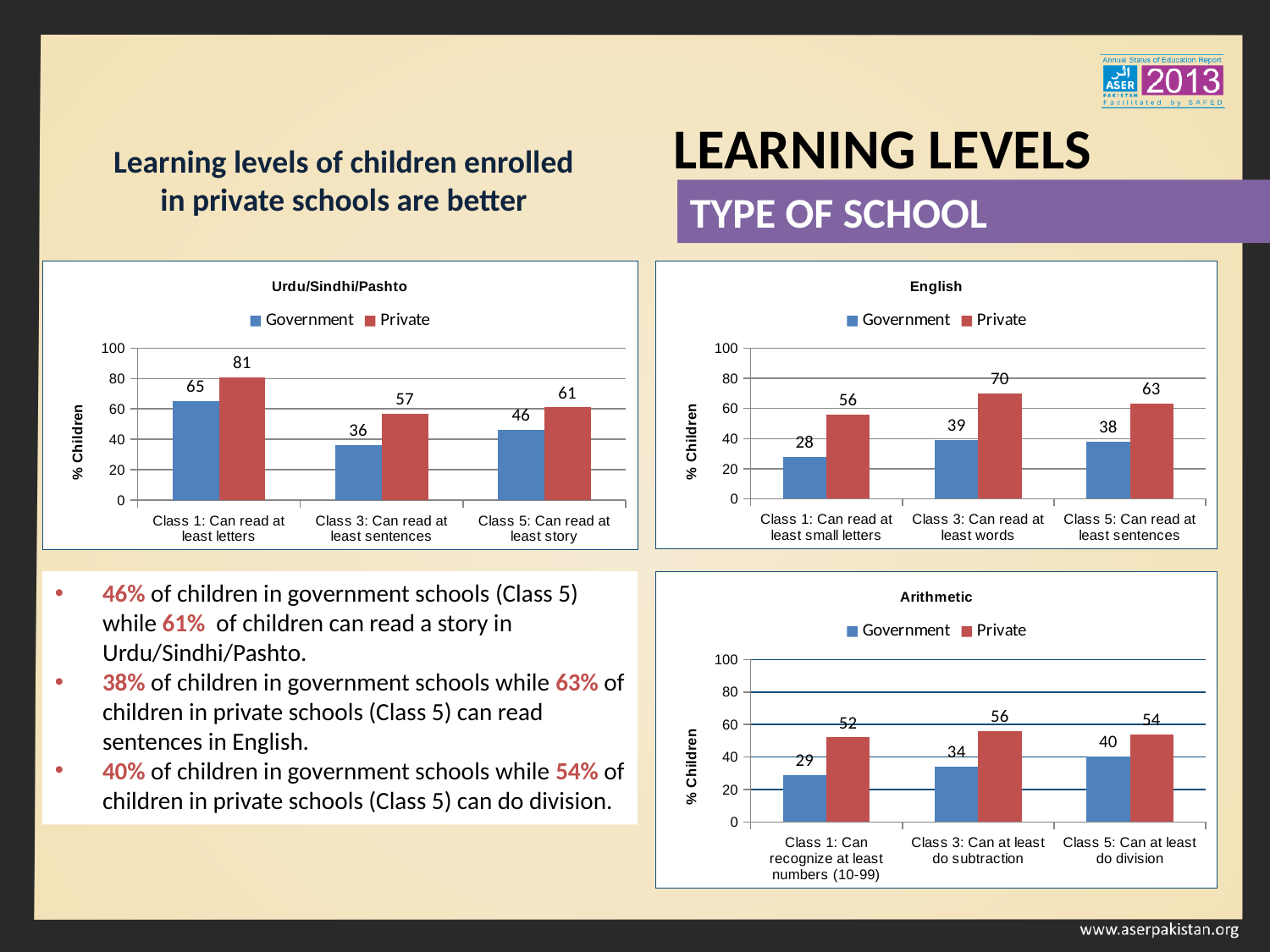
In the Urdu/Sindhi/Pashto chart, what is the Private value for Class 1: Can read at least letters? 81 In the English chart, what is the Government value for Class 1: Can read at least small letters? 28 How many categories are shown on the x axis of the Arithmetic chart? 3 In the Arithmetic chart, what is the Private value for Class 3: Can at least do subtraction? 56 In the Urdu/Sindhi/Pashto chart, what is the difference between the Private and Government values for Class 5: Can read at least story? 15 In the English chart, which category has the lowest Government value? Class 1: Can read at least small letters In the Arithmetic chart, what is the difference between the Private and Government values for Class 1: Can recognize at least numbers (10-99)? 23 In the Arithmetic chart, which is larger: the Government value for Class 5: Can at least do division or the Government value for Class 3: Can at least do subtraction? Class 5: Can at least do division In the English chart, which category has the highest Private value? Class 3: Can read at least words How many series does the legend of the English chart list? 2 What type of chart is the Urdu/Sindhi/Pashto chart? Bar chart In the Urdu/Sindhi/Pashto chart, what is the Government value for Class 3: Can read at least sentences? 36